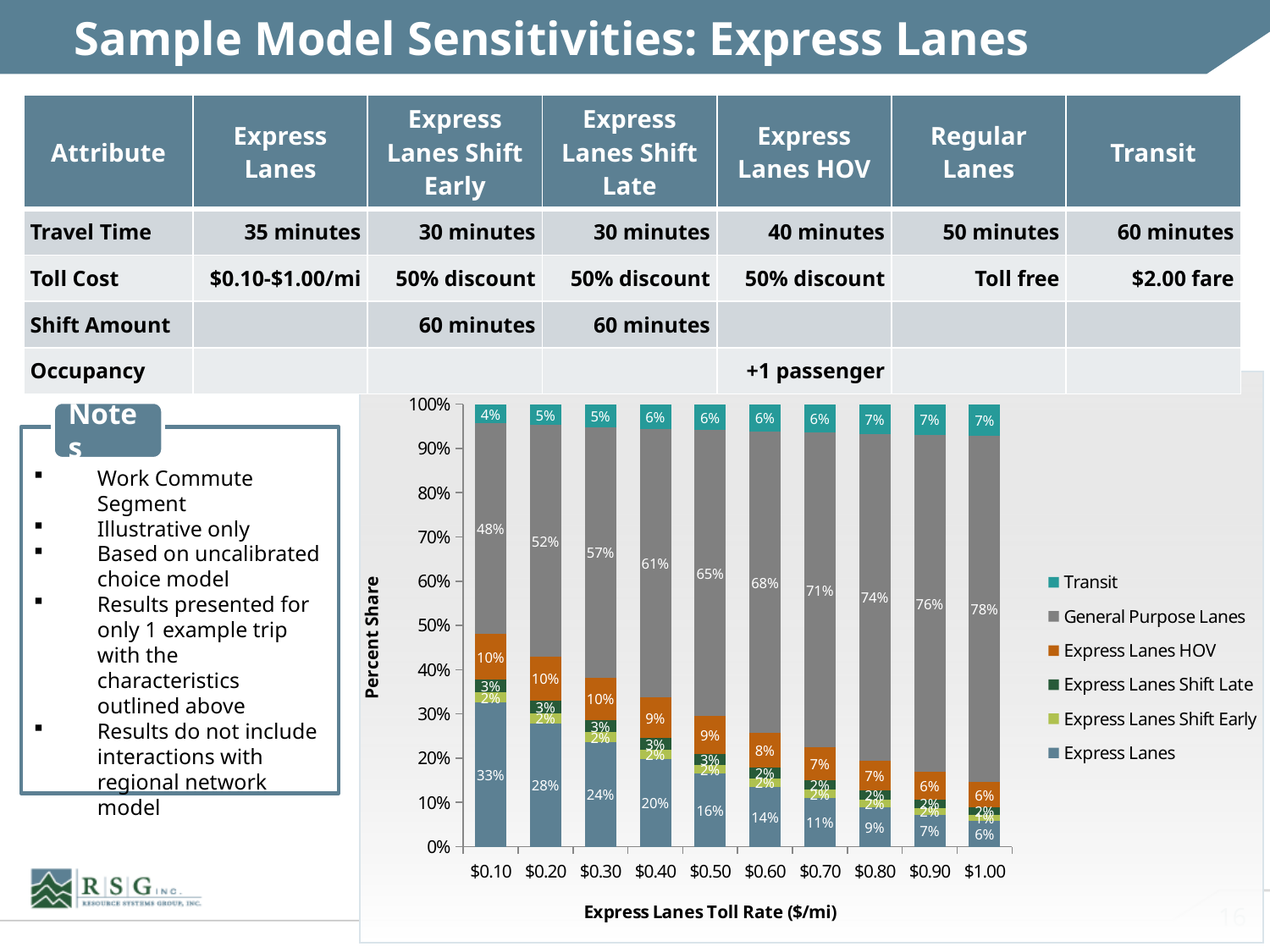
At which toll rate is the General Purpose Lanes share lowest? $0.10 Does the Express Lanes share rise or fall as the toll rate increases along the x axis? Fall What is the Express Lanes share at a toll rate of $0.10? 33% What is the Transit share at a toll rate of $0.50? 6% What is the label of the x axis of the chart? Express Lanes Toll Rate ($/mi) How many toll rate categories are shown on the x axis of the chart? 10 What is the Express Lanes HOV share at a toll rate of $0.70? 7% At which toll rate is the Express Lanes share highest? $0.10 How many series does the chart legend list? 6 What is the difference between the General Purpose Lanes share at $1.00 and at $0.10? 30% What is the General Purpose Lanes share at a toll rate of $1.00? 78% What type of chart is shown on the slide? Stacked bar chart